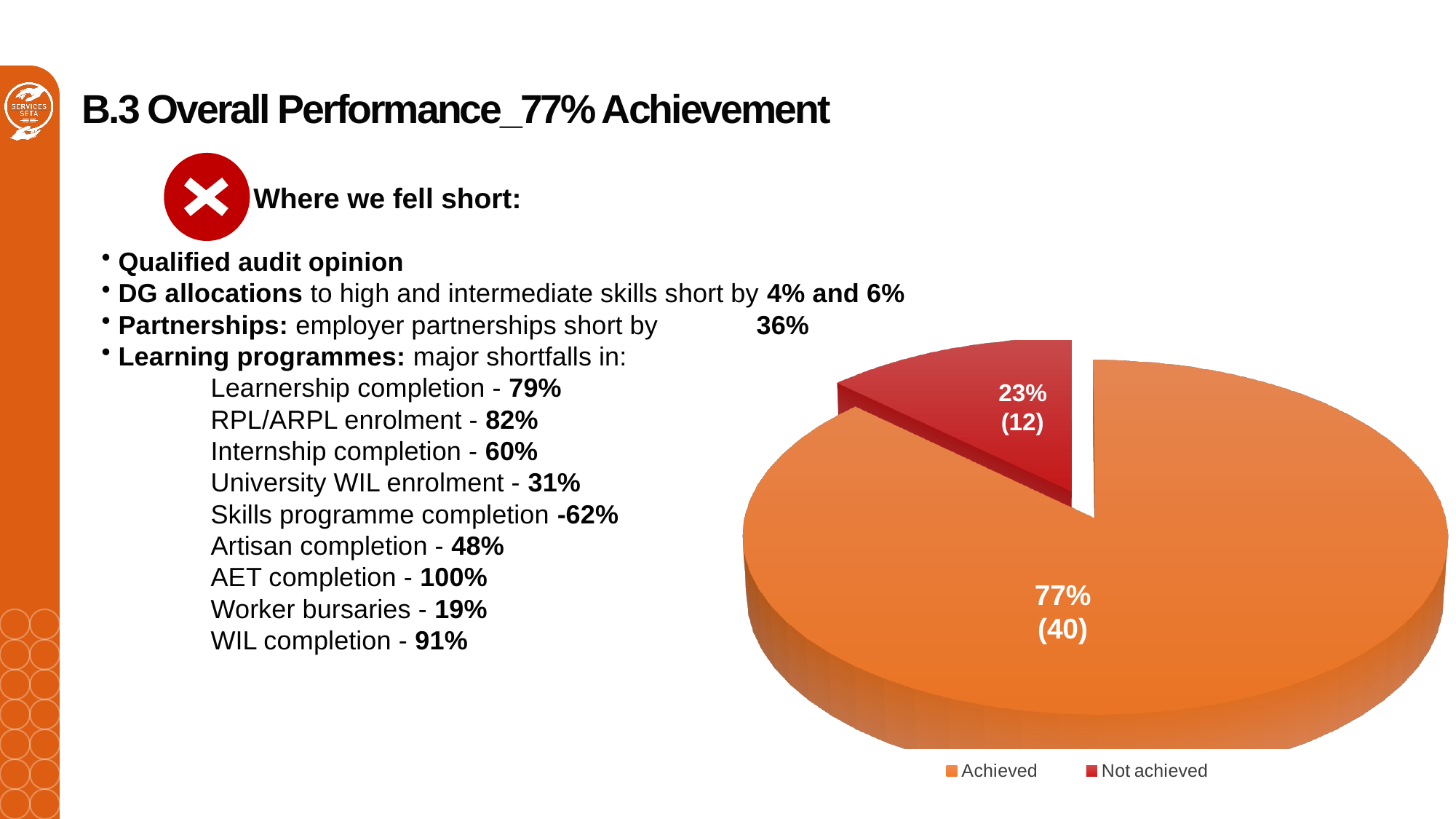
What count is shown in parentheses for the Not achieved slice? 12 What kind of chart is shown on the slide? pie chart How many slices does the pie chart have? 2 What is the difference between the counts for Achieved and Not achieved? 28 Which slice is the smallest in the pie chart? Not achieved Which is larger, the Achieved slice or the Not achieved slice? Achieved What count is shown in parentheses for the Achieved slice? 40 What percentage share does the Achieved slice have? 77% What percentage share does the Not achieved slice have? 23% Which slice is the largest in the pie chart? Achieved What colour is the Not achieved slice? red What is the difference in percentage points between the Achieved and Not achieved slices? 54